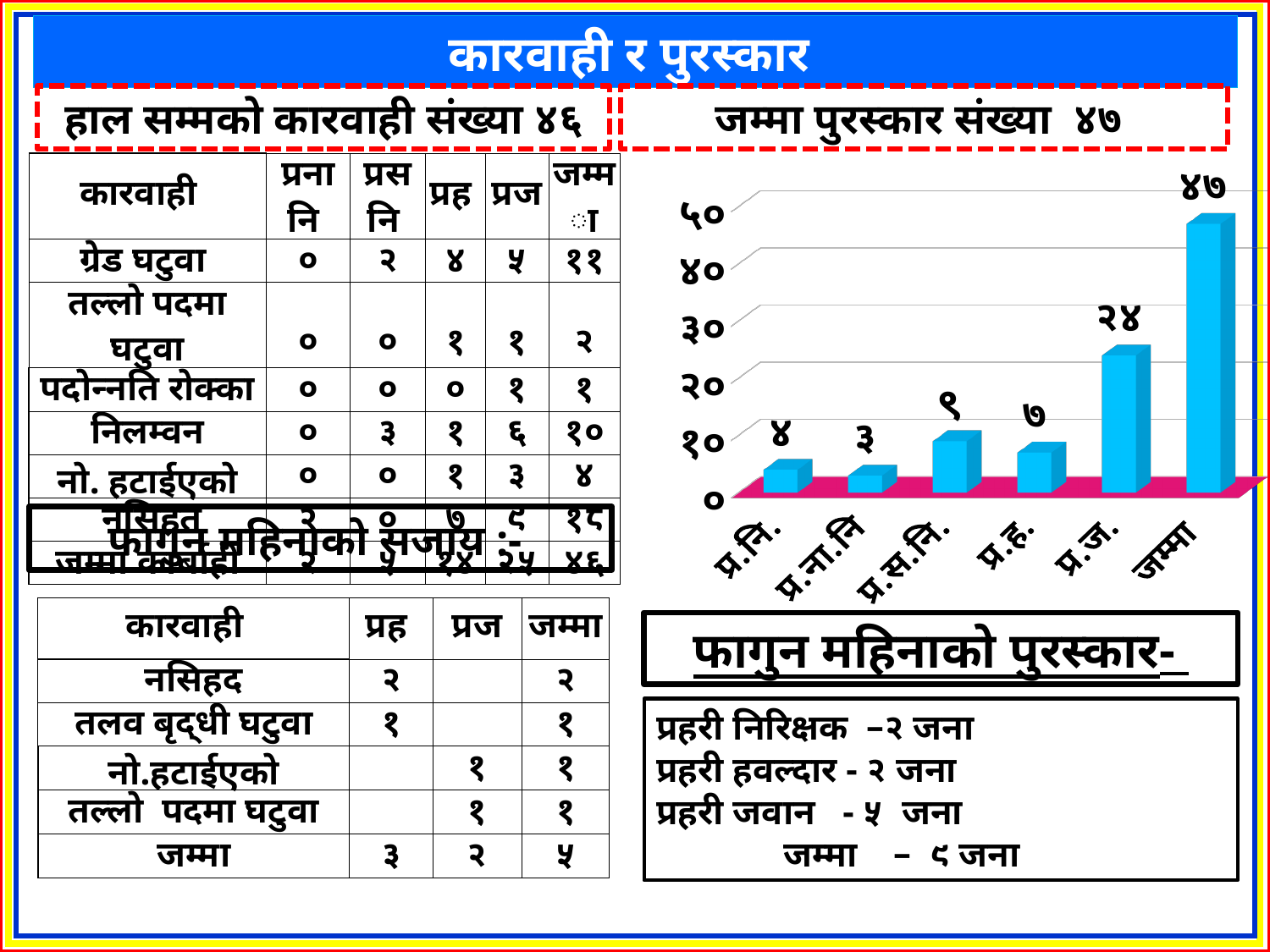
In the bar chart, what is the difference between the values for प्र.ज. and प्र.स.नि.? १५ In the bar chart, is the value for प्र.ज. greater or less than २०? greater In the bar chart, what is the value for जम्मा? ४७ In the bar chart, what is the value for प्र.ह.? ७ What colour are the bars in the chart? light blue In the bar chart, what is the value for प्र.स.नि.? ९ Which category has the highest bar in the chart? जम्मा In the bar chart, what is the value for प्र.ज.? २४ What type of chart is shown on the right side of the slide? bar chart How many bars are plotted in the chart? 6 In the bar chart, which is larger, the value for प्र.नि. or the value for प्र.ह.? प्र.ह. Which category has the lowest bar in the chart? प्र.ना.नि